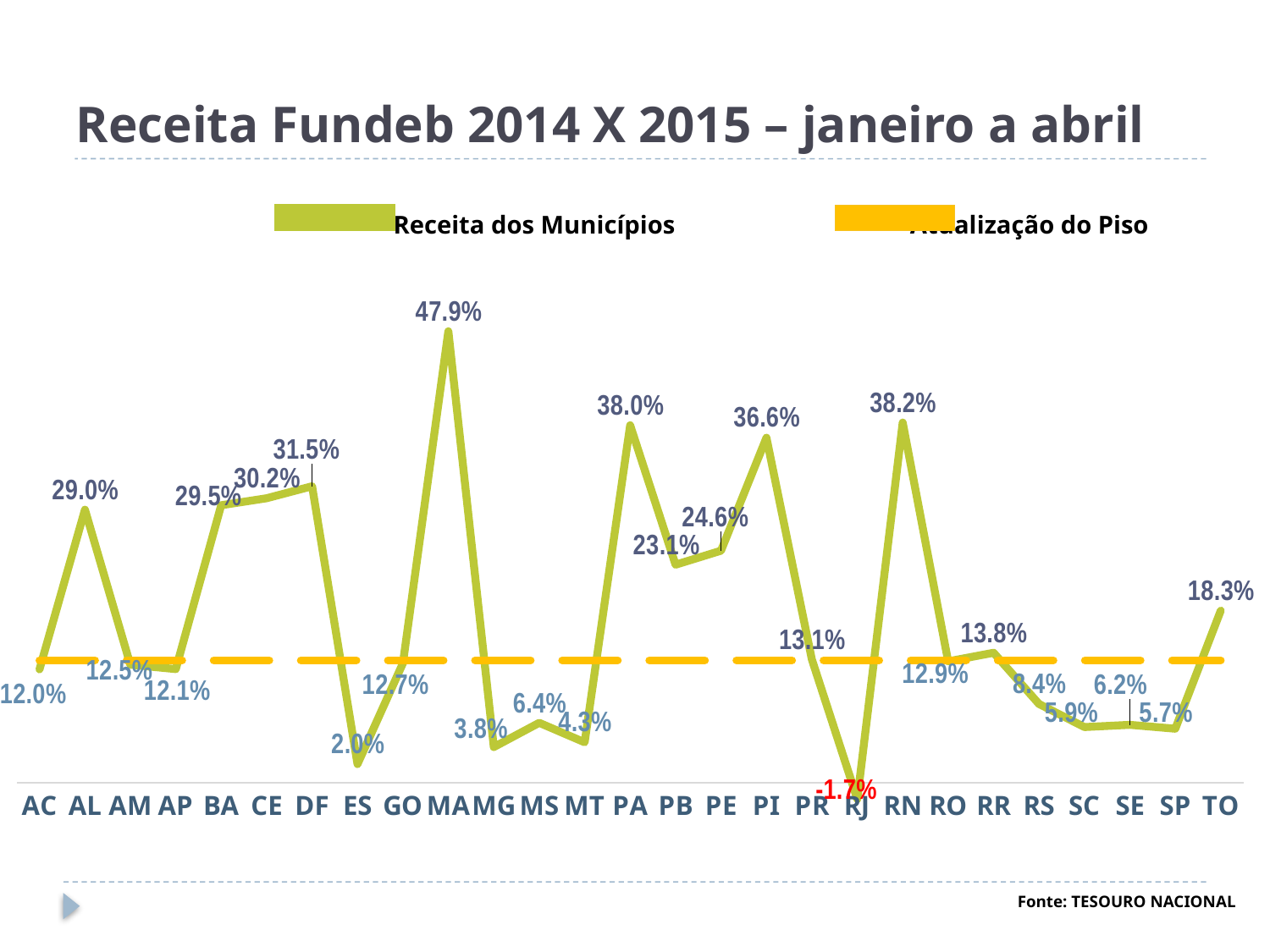
What is the Receita dos Municípios value for TO? 18.3% What is the title of the chart? Receita Fundeb 2014 X 2015 – janeiro a abril Which has a larger Receita dos Municípios value, AL or DF? DF How many states (categories) are shown on the x axis? 27 How many series does the legend list? 2 What is the Receita dos Municípios value for MA? 47.9% Which state has the lowest Receita dos Municípios value? RJ What type of chart is shown on the slide? Line chart What is the difference between the Receita dos Municípios values for MA and RN? 9.7 percentage points What is the Receita dos Municípios value for DF? 31.5% Which state has the highest Receita dos Municípios value? MA What is the Receita dos Municípios value for RJ? -1.7%